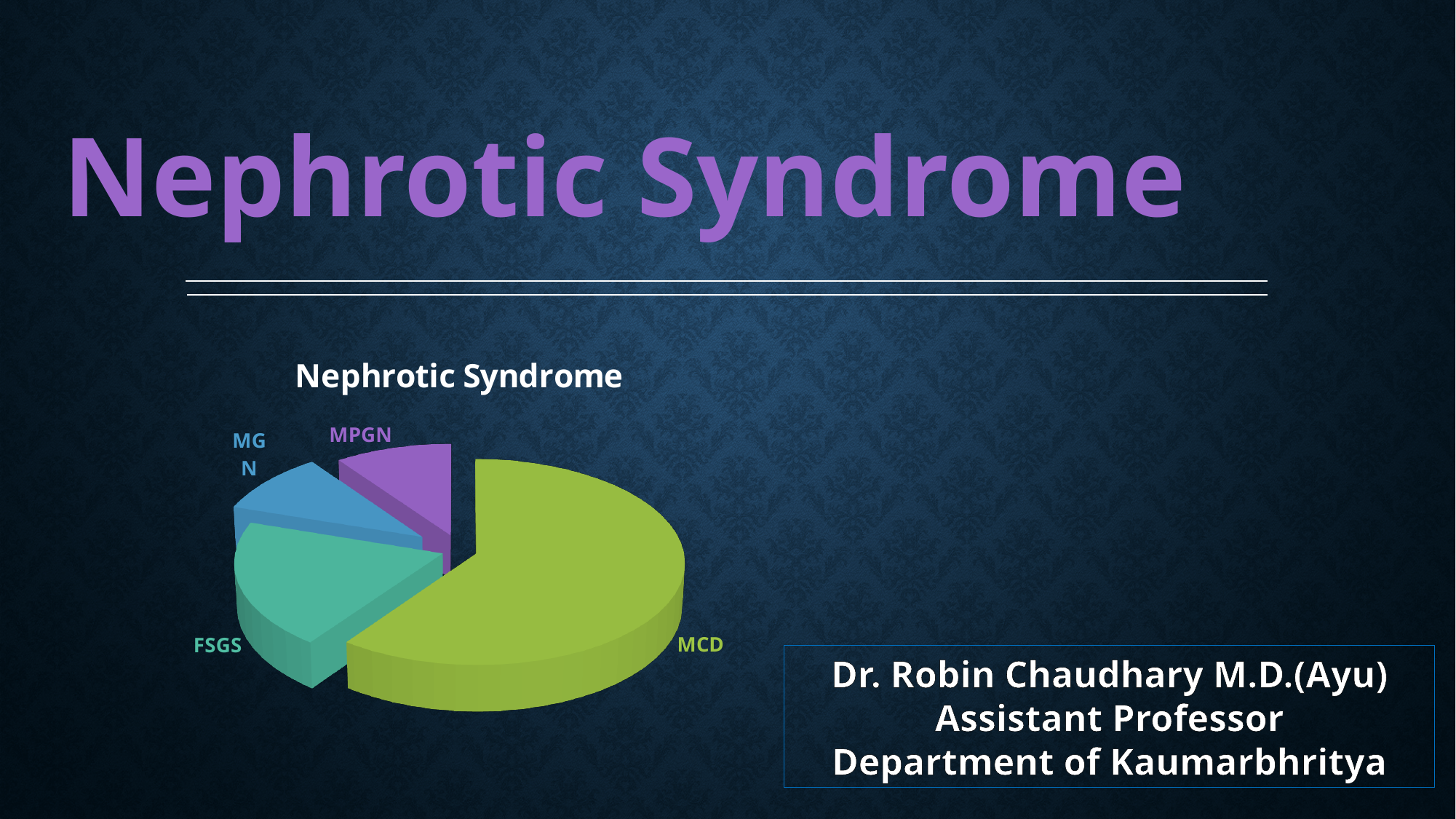
Which category has the largest slice of the pie? MCD Which slice is larger, MCD or FSGS? MCD Which slice is larger, MCD or MGN? MCD What colour is the MCD slice? green What kind of chart is shown on the slide? pie chart What is the title of the chart? Nephrotic Syndrome Which category is the second-largest slice of the pie? FSGS How many slices does the pie chart have? 4